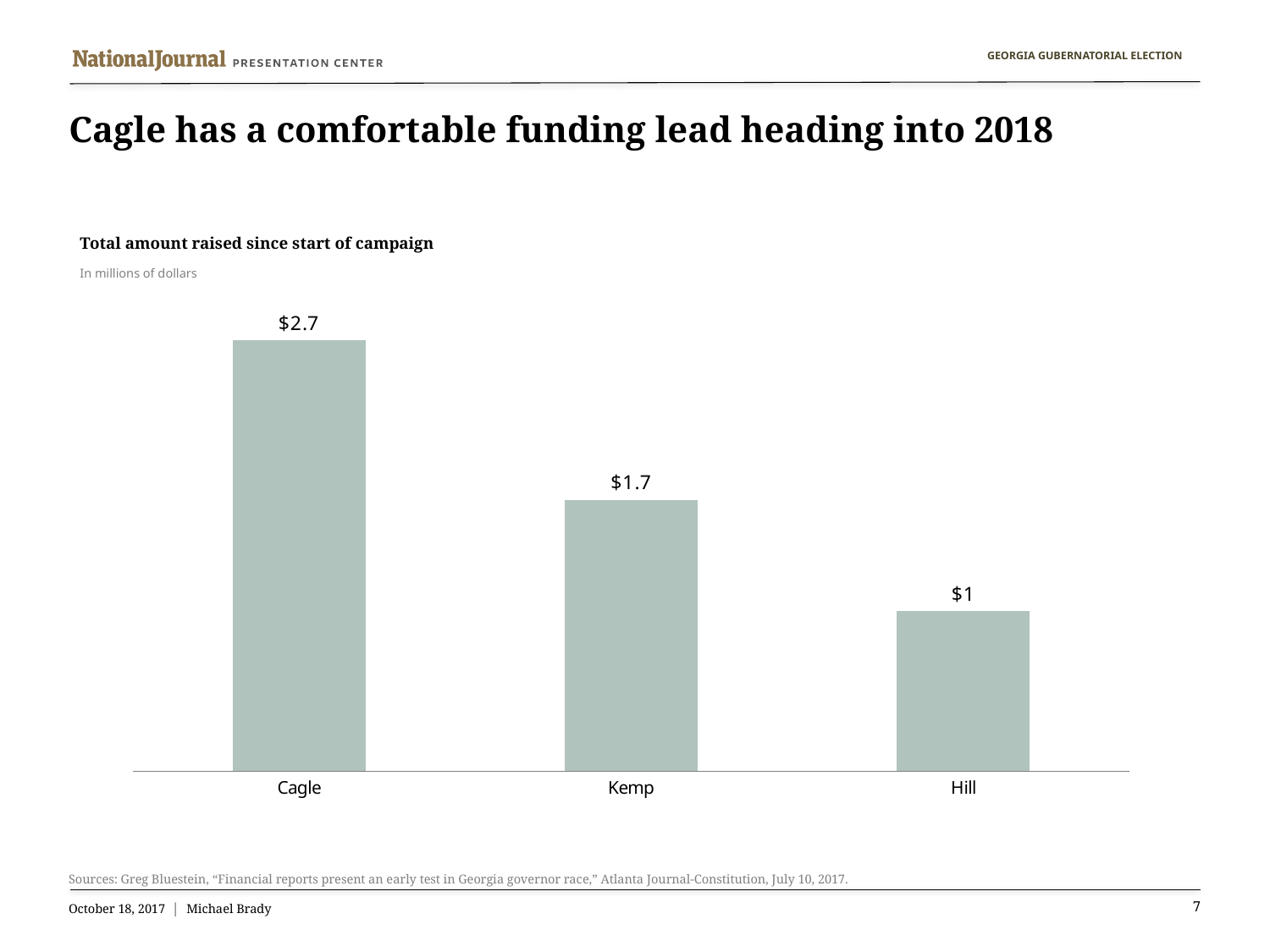
What is the difference between the amounts raised by Cagle and Kemp? $1 What is the total amount raised by Cagle? $2.7 Which candidate has raised the least money? Hill In what units are the chart values expressed? Millions of dollars How many candidates are shown in the chart? 3 What is the difference between the amounts raised by Kemp and Hill? $0.7 What is the total amount raised by Kemp? $1.7 Which candidate has raised the most money? Cagle Who has raised more, Kemp or Hill? Kemp What kind of chart is shown on the slide? Bar chart What is the total amount raised by Hill? $1 Do the values rise or fall from left to right across the chart? Fall